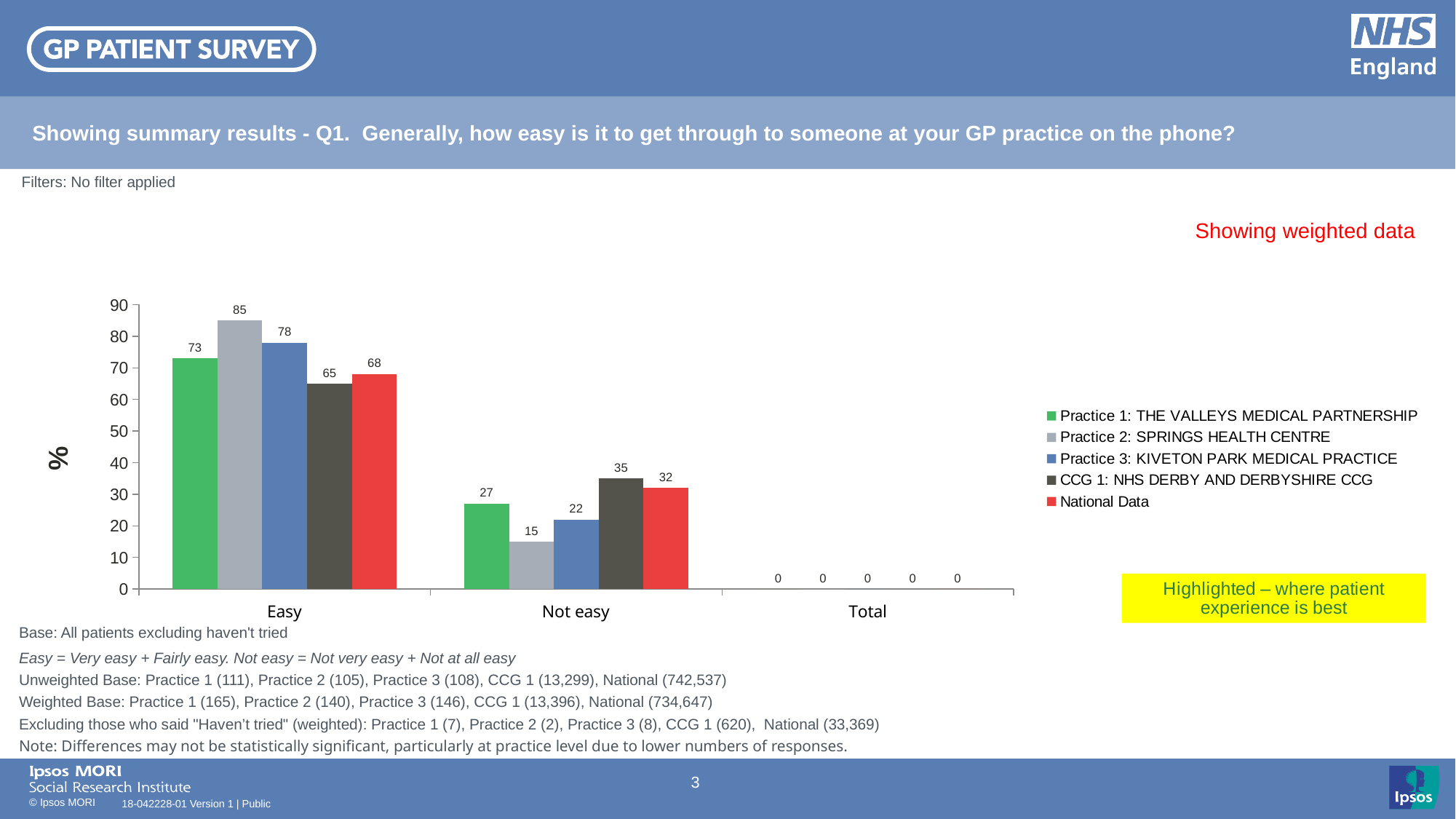
What is the value for National Data in the Not easy category? 32 What is the value shown for every series in the Total category? 0 What kind of chart is shown on the slide? Bar chart What is the value for Practice 2: SPRINGS HEALTH CENTRE in the Easy category? 85 What is the difference between Practice 3: KIVETON PARK MEDICAL PRACTICE and Practice 1: THE VALLEYS MEDICAL PARTNERSHIP in the Easy category? 5 How many categories are shown on the x axis? 3 Which series has the lowest value in the Not easy category? Practice 2: SPRINGS HEALTH CENTRE In the Not easy category, which is larger: CCG 1: NHS DERBY AND DERBYSHIRE CCG or National Data? CCG 1: NHS DERBY AND DERBYSHIRE CCG Which series has the highest value in the Easy category? Practice 2: SPRINGS HEALTH CENTRE What label is shown on the y axis? % What is the value for CCG 1: NHS DERBY AND DERBYSHIRE CCG in the Easy category? 65 How many series does the legend list? 5